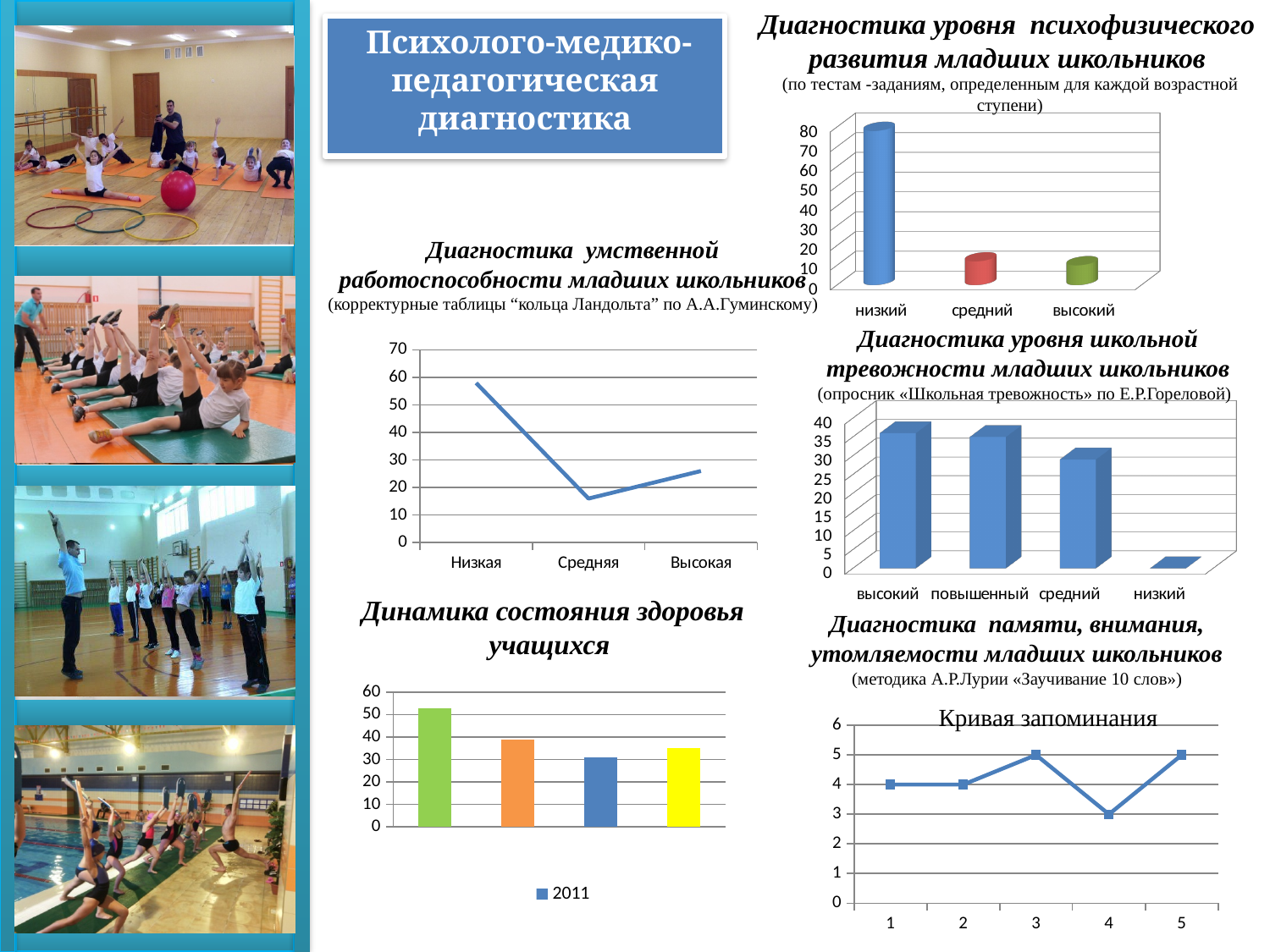
In the chart titled "Диагностика уровня психофизического развития младших школьников", is the value for низкий greater or less than 70? greater In the chart titled "Диагностика уровня психофизического развития младших школьников", which category has the highest value? низкий In the chart titled "Диагностика уровня школьной тревожности младших школьников", which category has the lowest value? низкий In the chart titled "Диагностика умственной работоспособности младших школьников", which category has the lowest value? Средняя In the chart titled "Диагностика уровня школьной тревожности младших школьников", how many categories are shown on the x axis? 4 In the chart titled "Кривая запоминания", how many points are plotted on the line? 5 In the chart titled "Динамика состояния здоровья учащихся", what entry does the legend list? 2011 In the chart titled "Кривая запоминания", what is the value at point 1? 4 What kind of chart is shown under the title "Динамика состояния здоровья учащихся"? bar chart In the chart titled "Кривая запоминания", what is the value at point 4? 3 In the chart titled "Диагностика умственной работоспособности младших школьников", is the value for Низкая greater or less than 50? greater In the chart titled "Кривая запоминания", what is the difference between the values at point 3 and point 4? 2